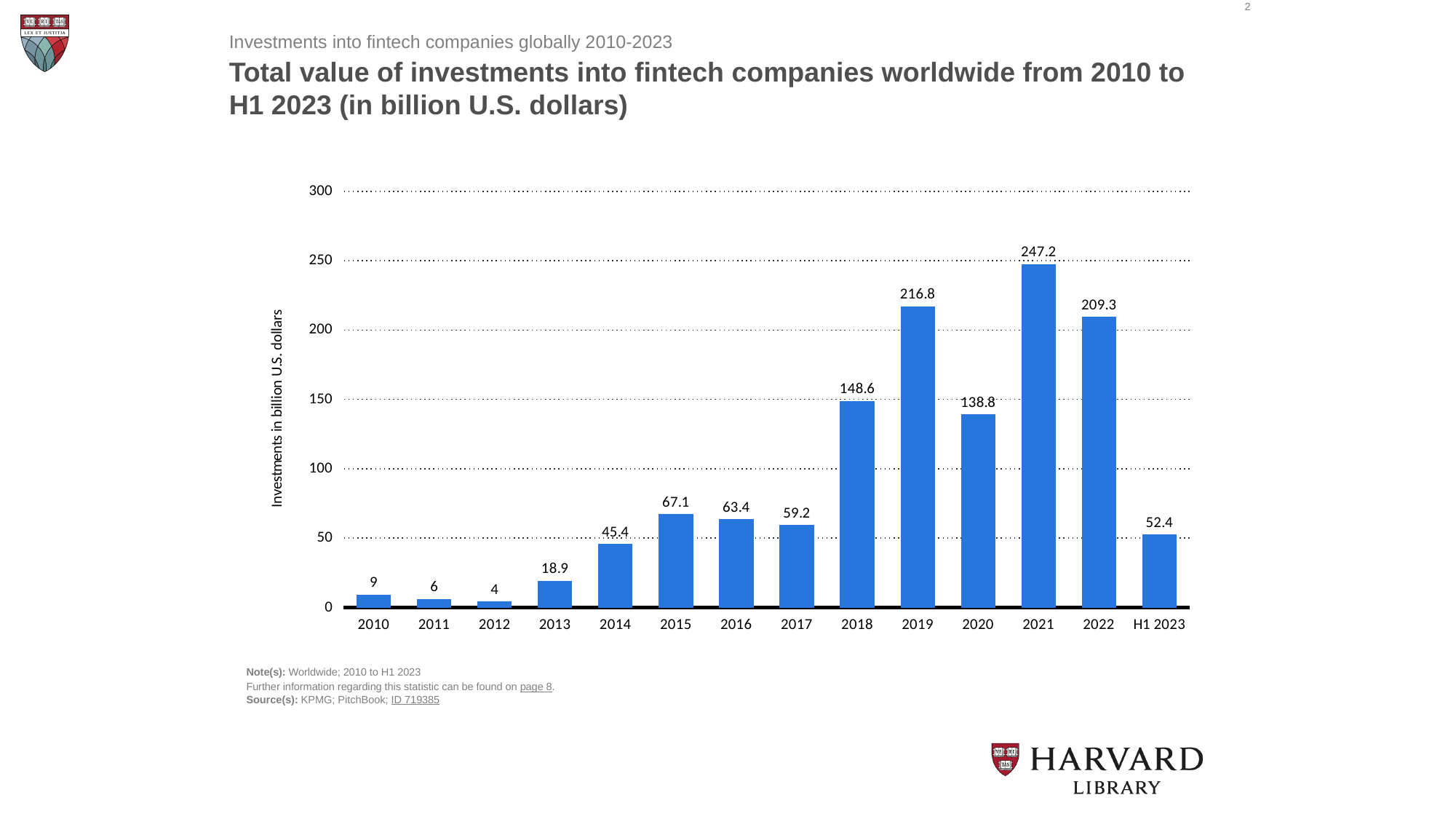
Is the value for 2018 greater or less than 100? greater Which year has a larger investment value, 2015 or 2017? 2015 Which year has the highest value of fintech investments? 2021 What is the value of investments into fintech companies in 2021? 247.2 What is the value of investments into fintech companies in H1 2023? 52.4 What kind of chart is shown on the slide? Bar chart What is the difference between the investment values for 2019 and 2020? 78 Which year has the lowest value of fintech investments? 2012 What is the value of investments into fintech companies in 2013? 18.9 What is the difference between the investment values for 2021 and 2022? 37.9 What is the label of the vertical axis? Investments in billion U.S. dollars How many bars are shown in the chart? 14